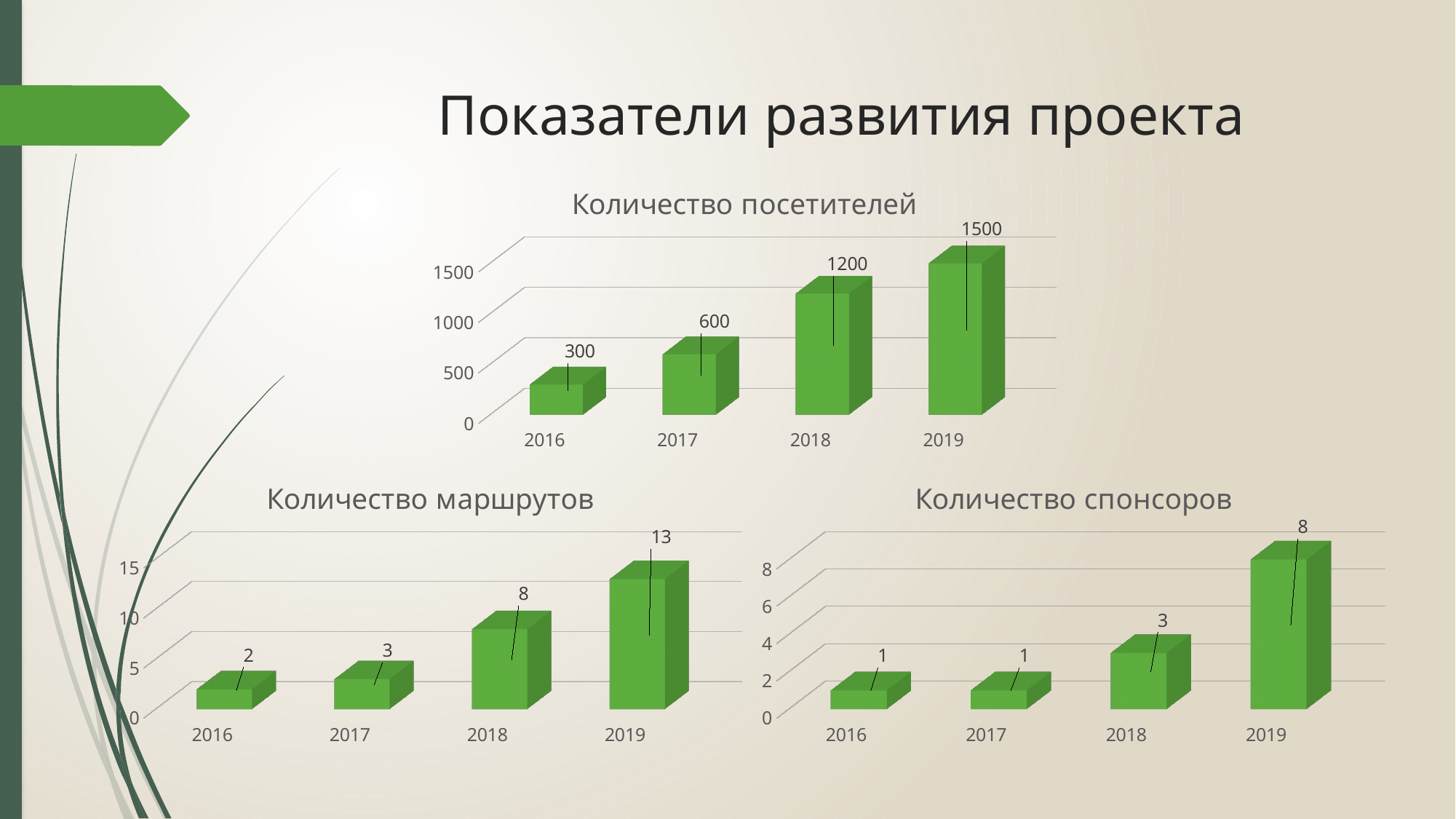
In the chart titled 'Количество маршрутов', what is the difference between the values for 2018 and 2017? 5 In the chart titled 'Количество посетителей', what is the value for 2018? 1200 In the chart titled 'Количество посетителей', which year has the highest value? 2019 In the chart titled 'Количество спонсоров', what is the value for 2018? 3 What kind of chart is the chart titled 'Количество спонсоров'? bar chart In the chart titled 'Количество спонсоров', which is larger, the value for 2019 or the value for 2018? 2019 In the chart titled 'Количество посетителей', do the values rise or fall from 2016 to 2019? rise In the chart titled 'Количество маршрутов', which year has the lowest value? 2016 In the chart titled 'Количество спонсоров', how many years are shown on the x axis? 4 In the chart titled 'Количество посетителей', what is the difference between the values for 2019 and 2016? 1200 In the chart titled 'Количество маршрутов', what is the value for 2019? 13 How many charts are shown on the slide? 3